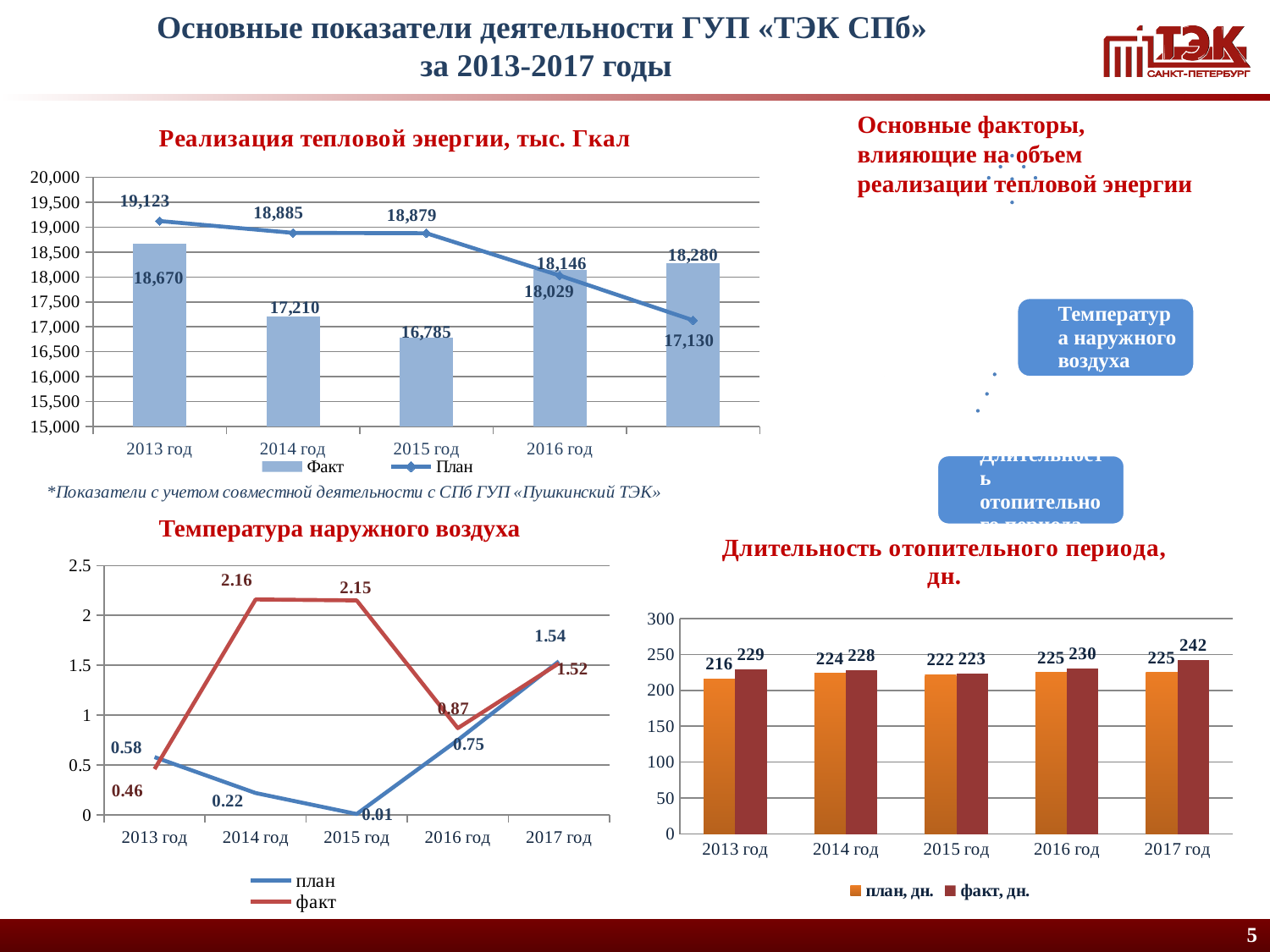
In the chart 'Температура наружного воздуха', which year has the highest факт value? 2014 год In the chart 'Реализация тепловой энергии, тыс. Гкал', what is the Факт value for 2015 год? 16,785 In the chart 'Температура наружного воздуха', what is the план value for 2015 год? 0.01 In the chart 'Длительность отопительного периода, дн.', what is the difference between факт, дн. and план, дн. for 2013 год? 13 What kind of chart is 'Длительность отопительного периода, дн.'? bar chart In the chart 'Длительность отопительного периода, дн.', what is the факт, дн. value for 2017 год? 242 In the chart 'Температура наружного воздуха', what is the факт value for 2014 год? 2.16 In the chart 'Температура наружного воздуха', how many series does the legend list? 2 In the chart 'Реализация тепловой энергии, тыс. Гкал', what is the difference between the План and Факт values for 2014 год? 1,675 In the chart 'Реализация тепловой энергии, тыс. Гкал', what is the План value for 2013 год? 19,123 In the chart 'Реализация тепловой энергии, тыс. Гкал', which year has the lowest Факт value? 2015 год In the chart 'Реализация тепловой энергии, тыс. Гкал', does the План line rise or fall from 2013 год to 2016 год? fall